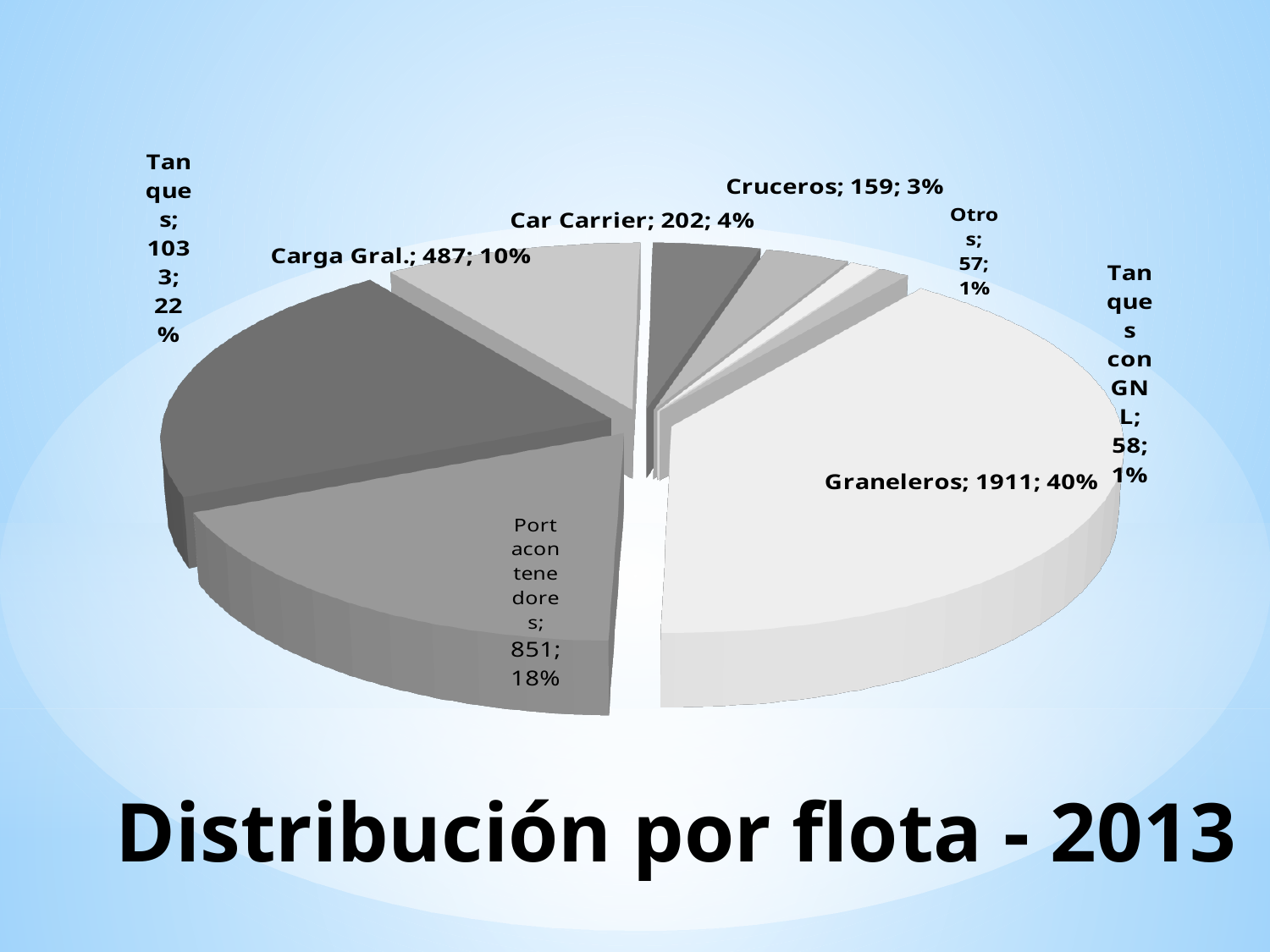
What is the difference between the values for Graneleros and Portacontenedores? 1060 Which category has the largest slice? Graneleros What is the value for Graneleros? 1911 What is the title of the slide? Distribución por flota - 2013 What is the value for Carga Gral.? 487 How many slices does the pie chart have? 8 What share of the pie does Tanques represent? 22% What type of chart is shown on the slide? pie chart Which is larger, the value for Cruceros or the value for Car Carrier? Car Carrier What is the value for Portacontenedores? 851 Which category has the smallest value? Otros What share of the pie does Car Carrier represent? 4%